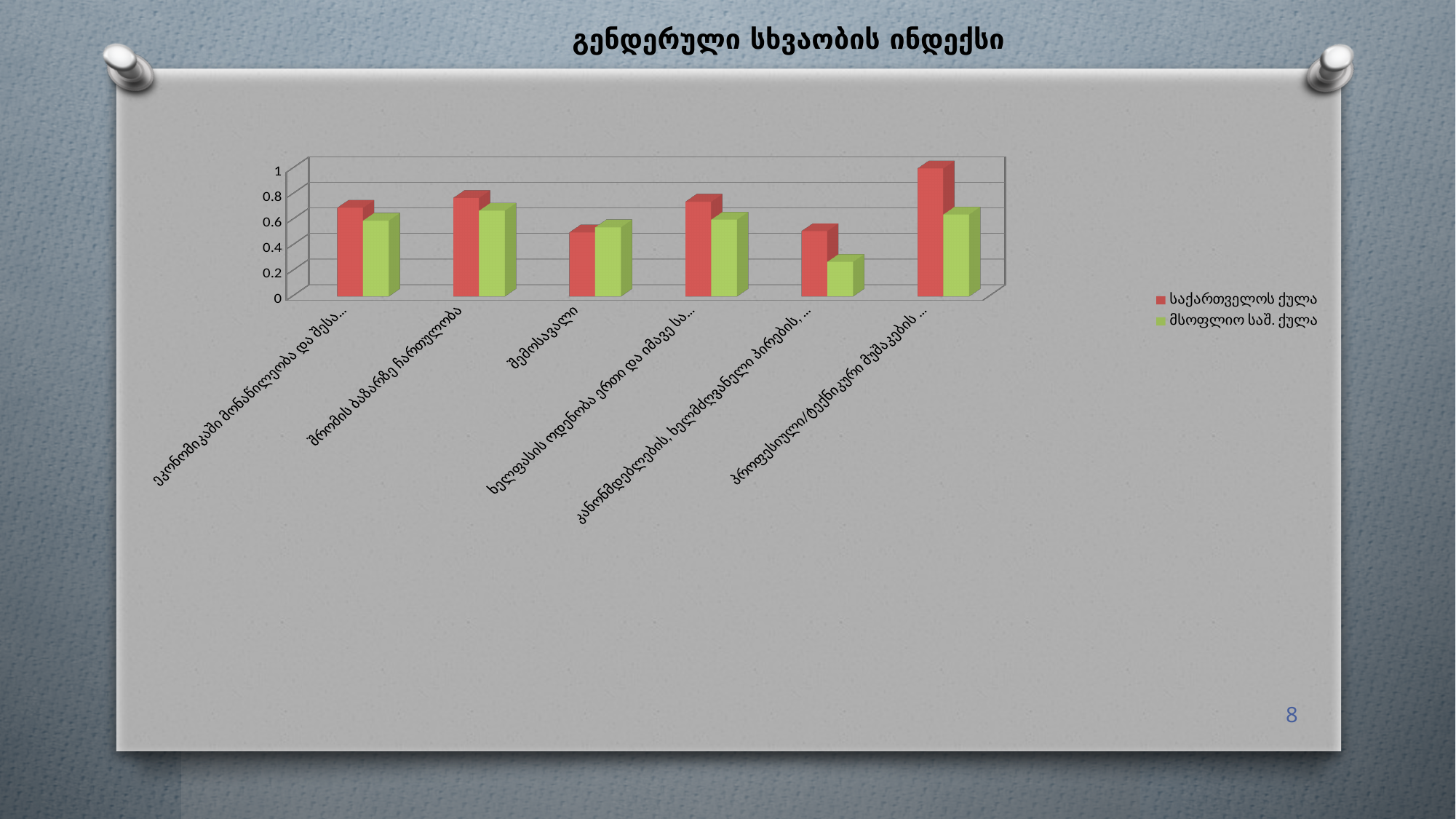
How many categories are shown on the x axis of the chart? 6 For კანონმდებლების, ხელმძღვანელი პირების, ..., which series has the larger value: საქართველოს ქულა or მსოფლიო საშ. ქულა? საქართველოს ქულა What kind of chart is shown on the slide? bar chart Is the value of მსოფლიო საშ. ქულა for კანონმდებლების, ხელმძღვანელი პირების, ... greater or less than 0.4? less Is the value of საქართველოს ქულა for შემოსავალი greater or less than 0.6? less Is the value of საქართველოს ქულა for პროფესიული/ტექნიკური მუშაკების ... greater or less than 0.8? greater For which category is the value of საქართველოს ქულა the highest? პროფესიული/ტექნიკური მუშაკების ... Which series is shown in red in the chart? საქართველოს ქულა How many series does the legend list? 2 For which category is the value of მსოფლიო საშ. ქულა the lowest? კანონმდებლების, ხელმძღვანელი პირების, ... What is the title of the chart on the slide? გენდერული სხვაობის ინდექსი For შრომის ბაზარზე ჩართულობა, which series has the larger value: საქართველოს ქულა or მსოფლიო საშ. ქულა? საქართველოს ქულა